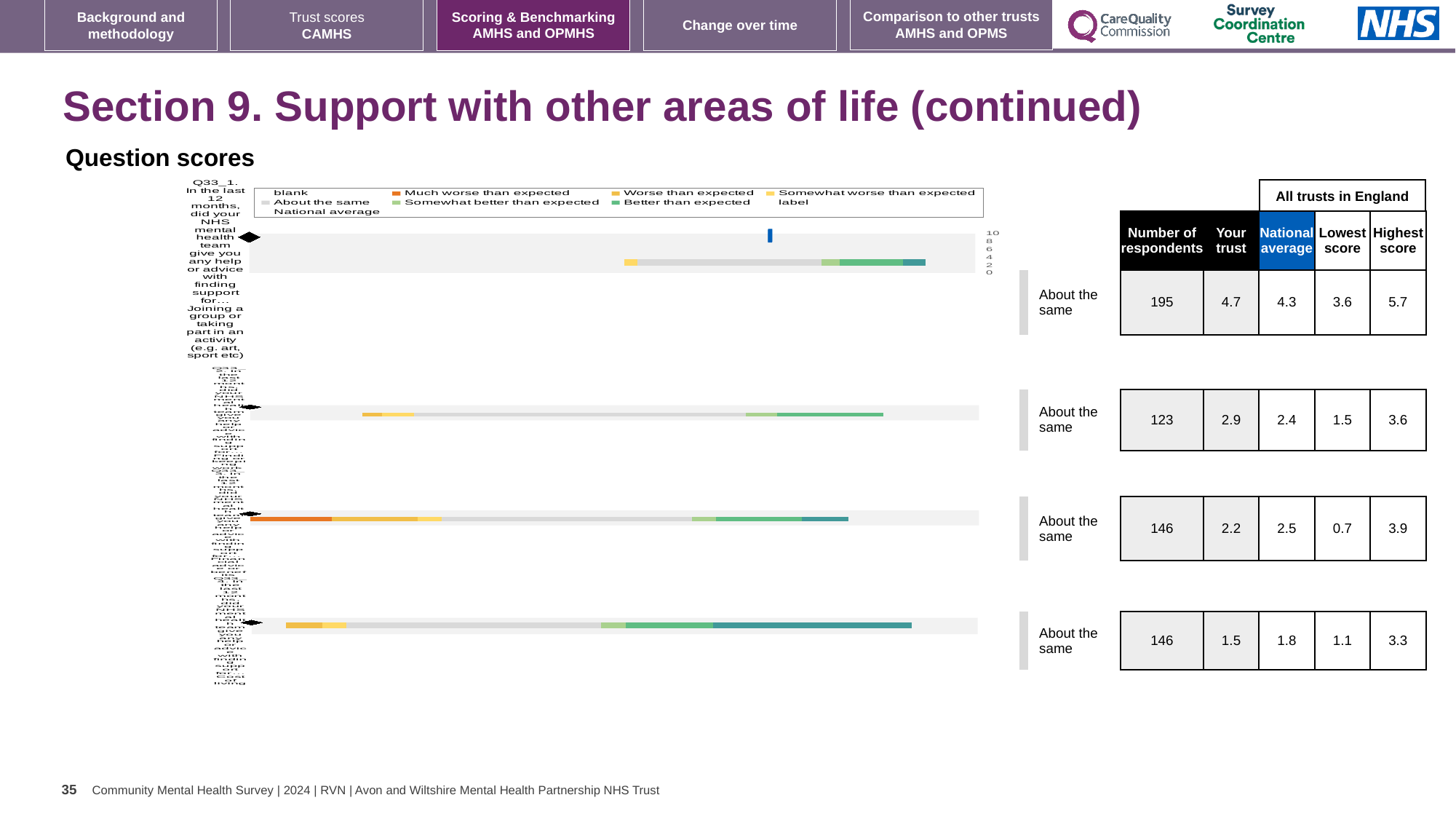
What is the national average score for Q33_1 (joining a group or taking part in an activity)? 4.3 What is the smallest number of respondents shown in the table? 123 What is the lowest score shown in the third row of the table? 0.7 What comparison label is shown next to each of the four bars? About the same How many horizontal bars (questions) are plotted in the chart? 4 For Q33_1 (joining a group or taking part in an activity), which is larger: the 'Your trust' score or the national average? Your trust What kind of chart is shown under 'Question scores'? bar chart What is the 'Your trust' score for Q33_1 (joining a group or taking part in an activity)? 4.7 Which row of the table has the highest 'Your trust' score? The first row (Q33_1, joining a group or taking part in an activity), 4.7 In the second row of the table, what is the difference between the 'Your trust' score and the national average? 0.5 For Q33_1 (joining a group or taking part in an activity), what is the difference between the highest score and the lowest score across all trusts in England? 2.1 In the table beside the chart, what is the number of respondents for Q33_1 (help finding support for joining a group or taking part in an activity)? 195